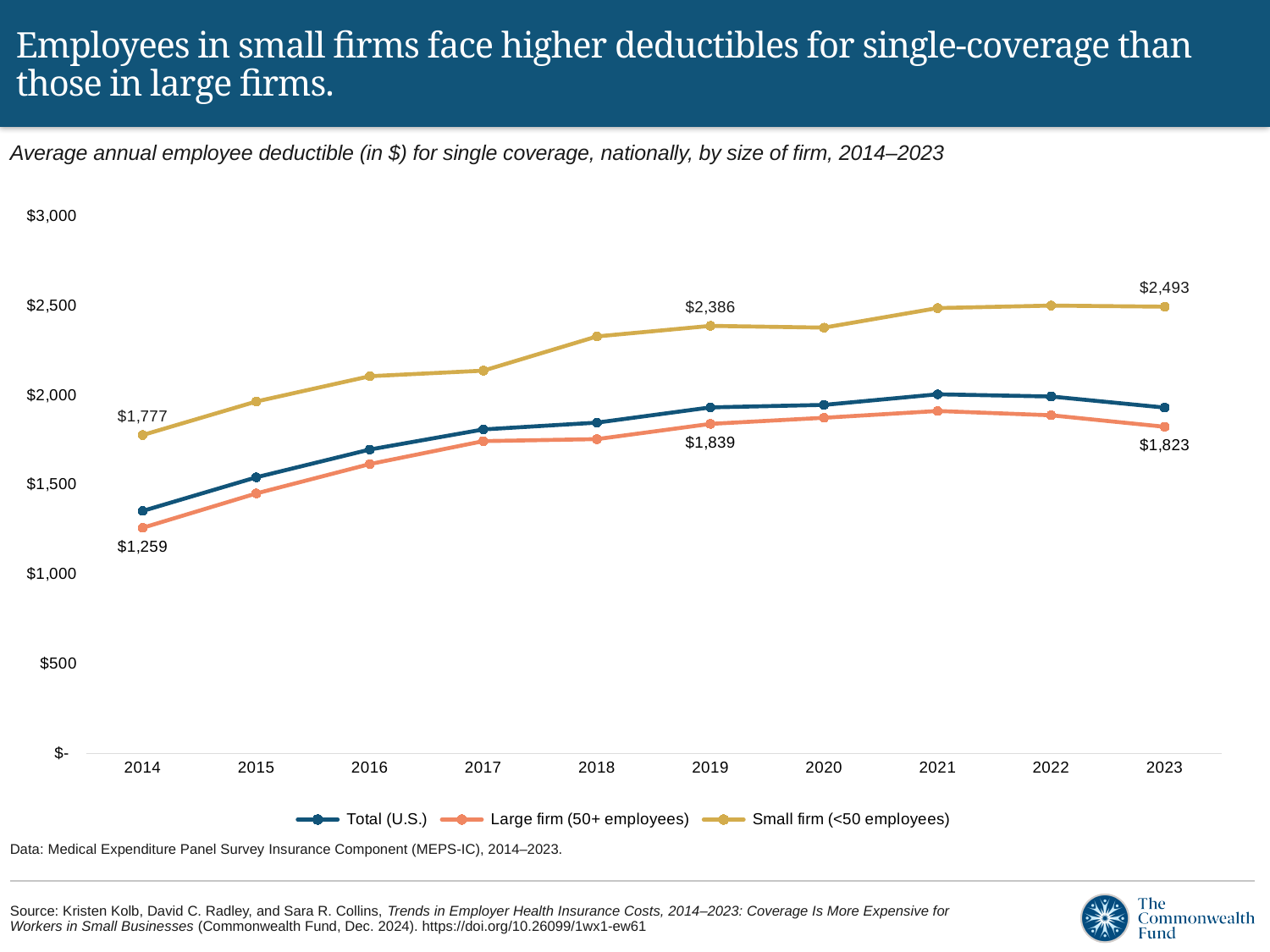
What kind of chart is shown on the slide? Line chart What was the average annual employee deductible for single coverage at small firms (<50 employees) in 2019? $2,386 What is the difference between the small firm and large firm deductibles in 2023? $670 Is the Total (U.S.) deductible in 2021 greater or less than $1,500? greater How many series does the chart's legend list? 3 What was the average annual employee deductible for single coverage at large firms (50+ employees) in 2014? $1,259 What was the average annual employee deductible for single coverage at small firms (<50 employees) in 2014? $1,777 What is the difference between the small firm and large firm deductibles in 2014? $518 How many years are shown on the x axis of the chart? 10 Is the small firm deductible in 2016 greater or less than $2,500? less What was the average annual employee deductible for single coverage at large firms (50+ employees) in 2023? $1,823 Which series had the higher deductible in 2019, small firms or large firms? Small firm (<50 employees)